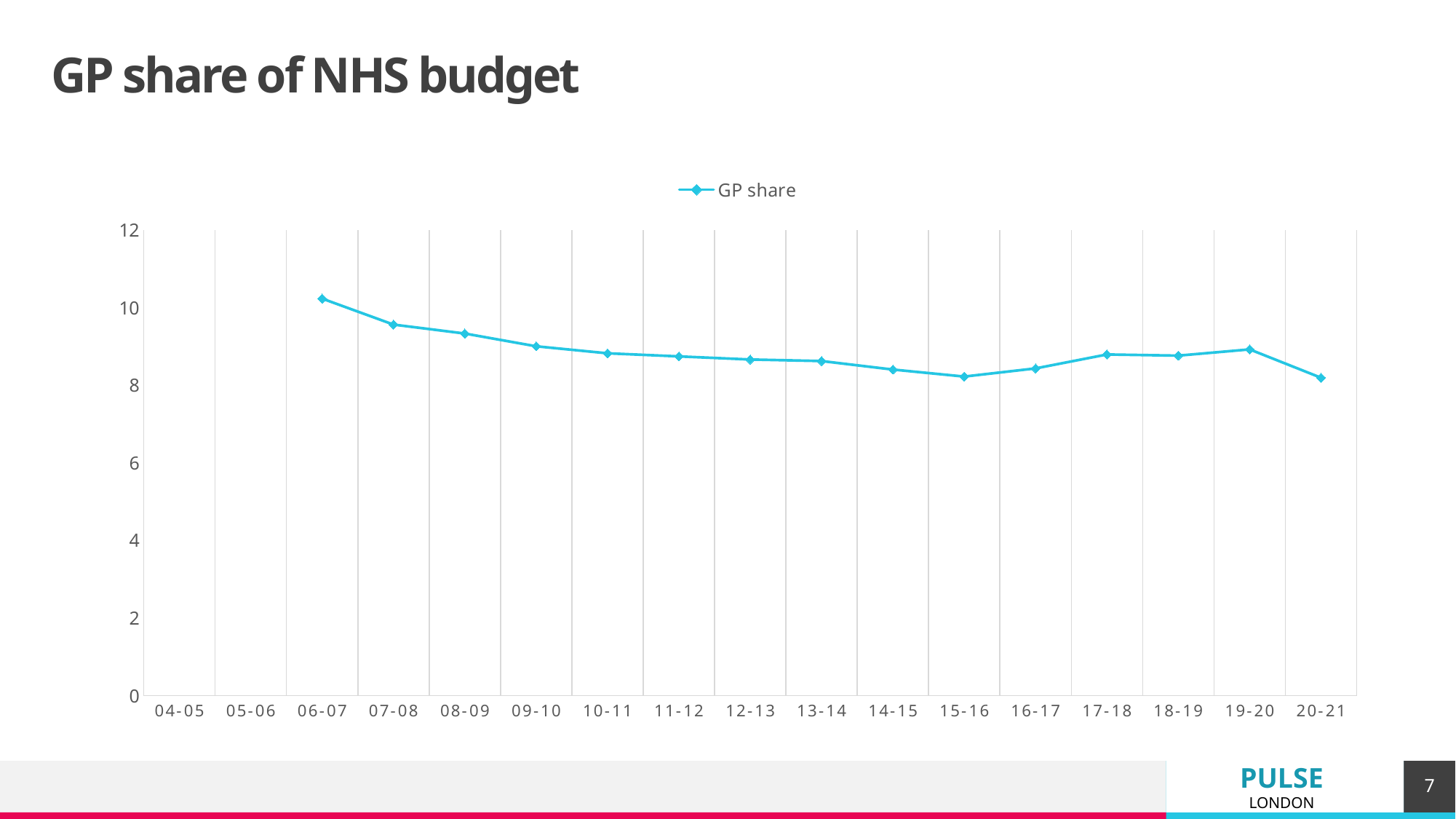
How many series does the legend list? 1 How many financial years are labelled on the x axis? 17 Which is larger, the GP share for 07-08 or for 15-16? 07-08 Is the GP share for 14-15 greater or less than 10? less Is the GP share for 06-07 greater or less than 10? greater What is the title of the chart on the slide? GP share of NHS budget Which year has the highest GP share? 06-07 What is the name of the series shown in the legend? GP share What kind of chart is shown on the slide? Line chart Does the GP share rise or fall from 06-07 to 15-16? Fall Is the GP share for 07-08 greater or less than 10? less Which is larger, the GP share for 06-07 or for 20-21? 06-07